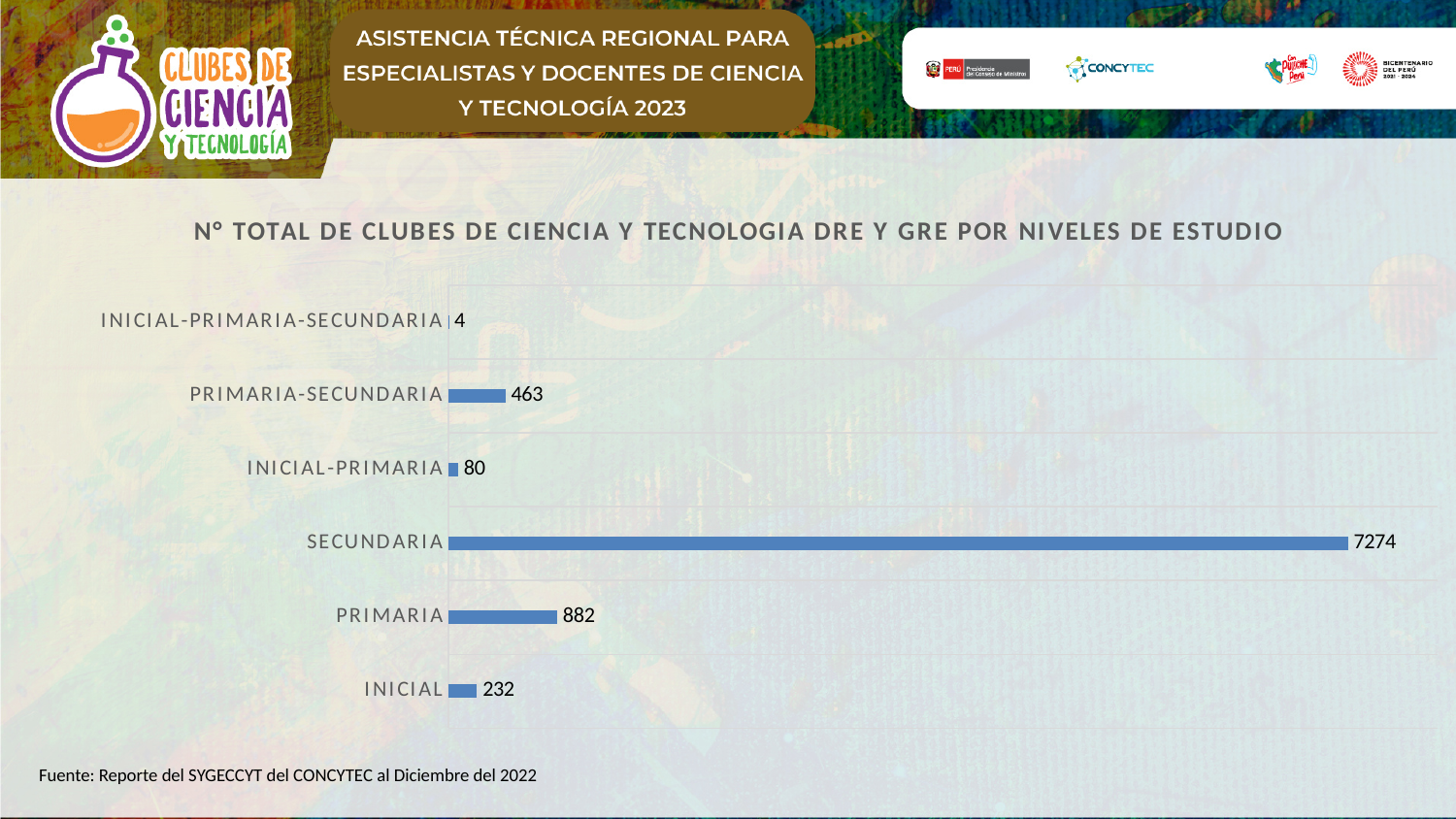
What is the value for INICIAL-PRIMARIA? 80 What is the title of the chart? N° TOTAL DE CLUBES DE CIENCIA Y TECNOLOGIA DRE Y GRE POR NIVELES DE ESTUDIO What kind of chart is shown on the slide? Bar chart Which category has the highest value? SECUNDARIA What is the value for SECUNDARIA? 7274 Which category has the lowest value? INICIAL-PRIMARIA-SECUNDARIA How many categories are shown in the chart? 6 Which is larger, the value for PRIMARIA or the value for PRIMARIA-SECUNDARIA? PRIMARIA What is the difference between the values for SECUNDARIA and PRIMARIA? 6392 What is the difference between the values for PRIMARIA and INICIAL? 650 What is the value for INICIAL? 232 What is the value for PRIMARIA-SECUNDARIA? 463